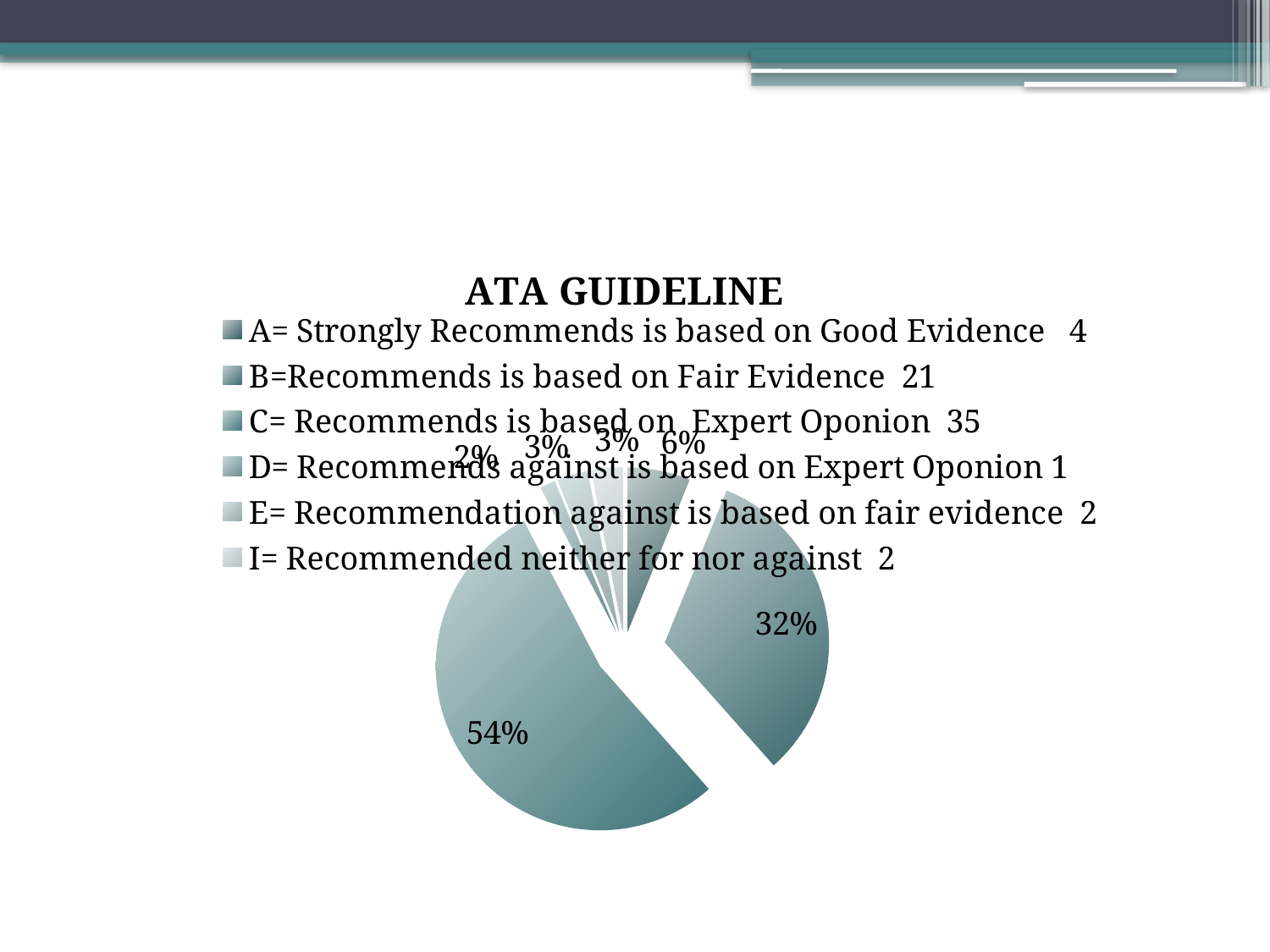
What is the title of the chart? ATA GUIDELINE What number is shown in the legend for 'A= Strongly Recommends is based on Good Evidence'? 4 What is the share of the largest slice of the pie chart? 54% Which has the larger value, category B or category A? B How many categories does the legend of the pie chart list? 6 What is the difference between the legend values for category C and category B? 14 Which category has the largest slice of the pie chart? C= Recommends is based on Expert Oponion Which category has the smallest value in the legend? D= Recommends against is based on Expert Oponion What kind of chart is shown on the slide? pie chart What is the share of the smallest slice of the pie chart? 2% What share of the pie does the category 'B=Recommends is based on Fair Evidence' have? 32% What number is shown in the legend for 'C= Recommends is based on Expert Oponion'? 35